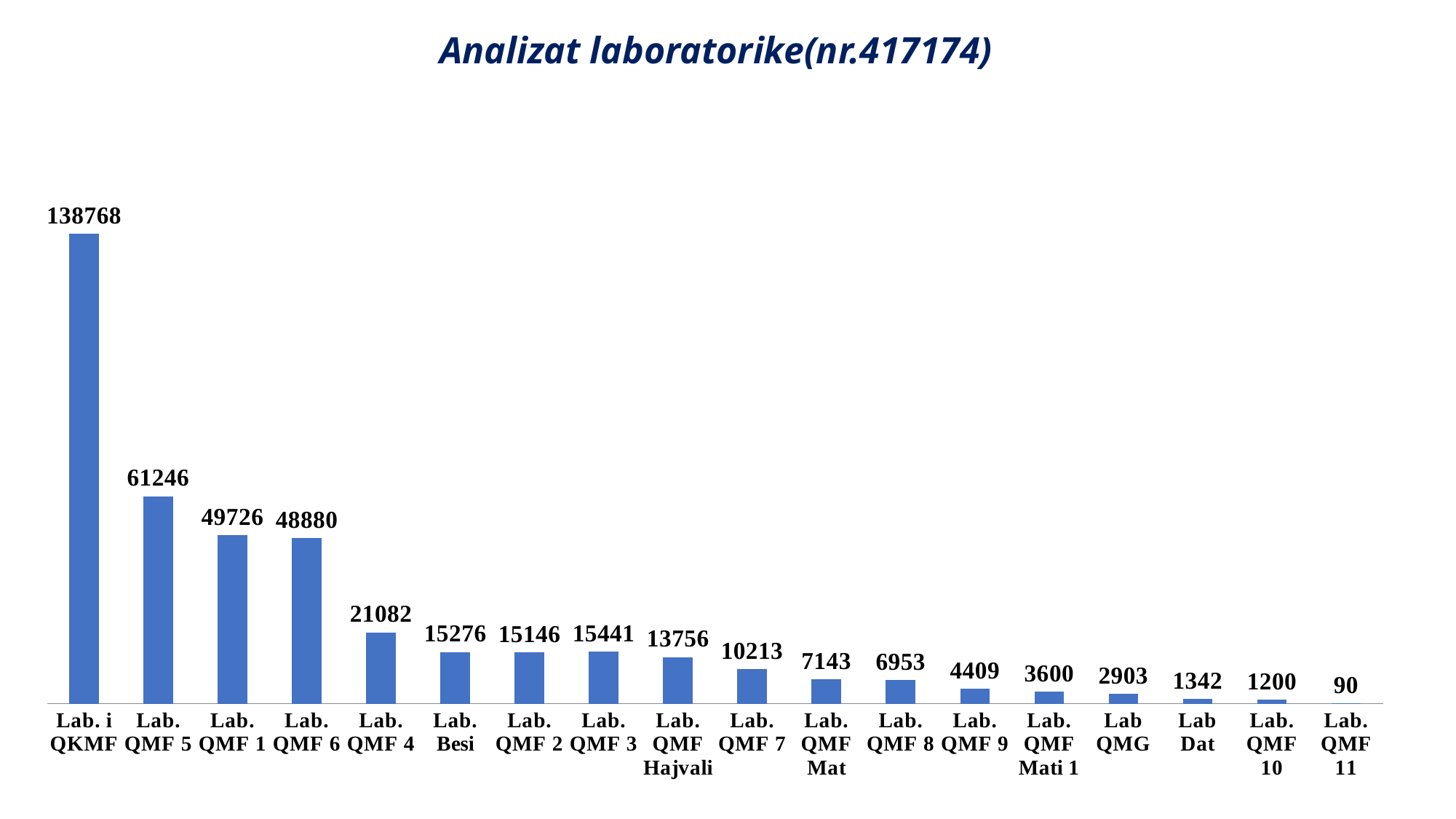
What is the value for Lab. QMF Hajvali? 13756 Which is larger, the value for Lab. QMF 4 or the value for Lab. Besi? Lab. QMF 4 Which category has the highest value? Lab. i QKMF What kind of chart is shown on the slide? Bar chart Which is larger, the value for Lab. QMF 3 or the value for Lab. QMF 2? Lab. QMF 3 What is the value for Lab. QMF 5? 61246 What is the difference between the values for Lab. i QKMF and Lab. QMF 5? 77522 What is the difference between the values for Lab. QMF 1 and Lab. QMF 6? 846 What is the title of the chart? Analizat laboratorike(nr.417174) How many categories are shown in the chart? 18 What is the value for Lab. QMF 11? 90 Which category has the lowest value? Lab. QMF 11